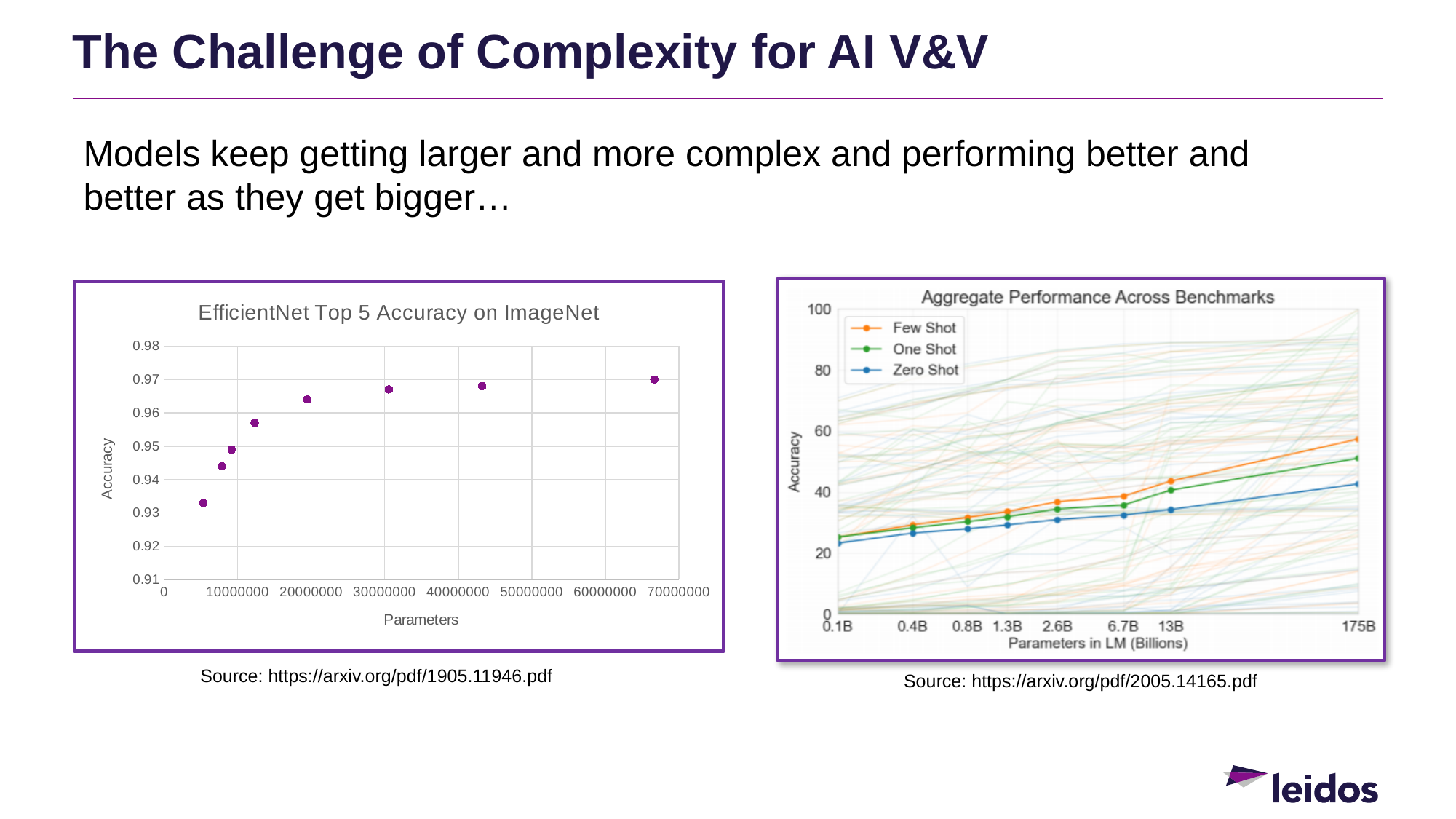
In the left chart 'EfficientNet Top 5 Accuracy on ImageNet', how many data points are plotted? 8 In the right chart 'Aggregate Performance Across Benchmarks', how many parameter sizes are labelled on the x axis? 8 What type of chart is the right chart titled 'Aggregate Performance Across Benchmarks'? Line chart In the right chart 'Aggregate Performance Across Benchmarks', what are the three series named in the legend? Few Shot, One Shot, Zero Shot In the left chart 'EfficientNet Top 5 Accuracy on ImageNet', does accuracy rise or fall as the number of parameters increases? Rise In the right chart 'Aggregate Performance Across Benchmarks', does the Few Shot accuracy rise or fall as parameters increase? Rise In the right chart 'Aggregate Performance Across Benchmarks', which series has the higher accuracy at 175B, Few Shot or Zero Shot? Few Shot What type of chart is the left chart titled 'EfficientNet Top 5 Accuracy on ImageNet'? Scatter chart In the right chart 'Aggregate Performance Across Benchmarks', is the Zero Shot accuracy at 0.1B greater or less than 40? less In the right chart 'Aggregate Performance Across Benchmarks', is the Few Shot accuracy at 175B greater or less than 50? greater In the left chart 'EfficientNet Top 5 Accuracy on ImageNet', is the accuracy of the smallest model (fewest parameters) greater or less than 0.94? less In the right chart 'Aggregate Performance Across Benchmarks', how many series does the legend list? 3